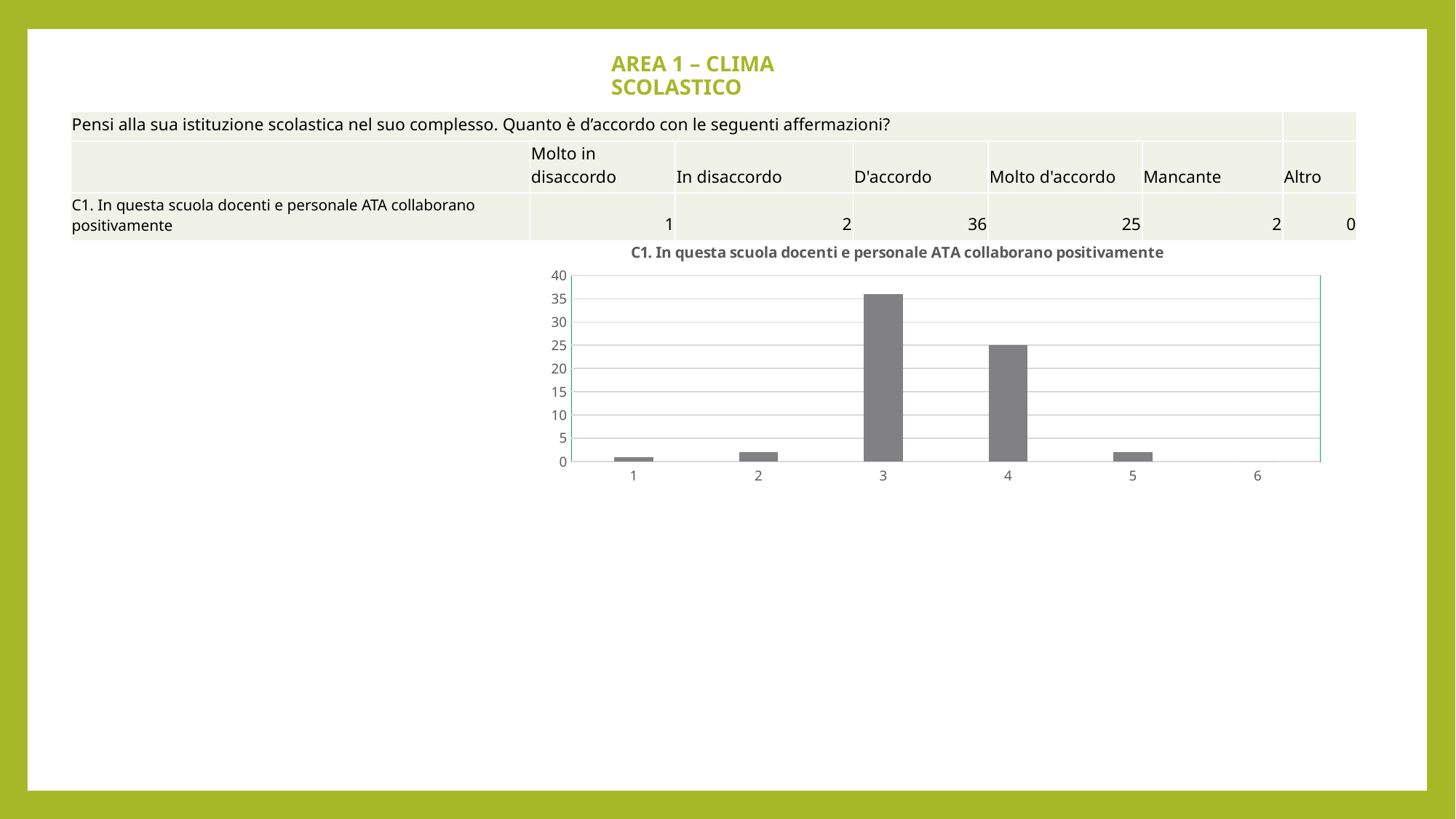
Which is larger, the value for category 2 or the value for category 4? category 4 Is the value for category 5 greater or less than 5? less What is the title of the chart? C1. In questa scuola docenti e personale ATA collaborano positivamente What is the difference between the values for category 3 and category 4? 11 Is the value for category 3 greater or less than 30? greater What is the value of the bar for category 3 (D'accordo)? 36 What is the value of the bar for category 4 (Molto d'accordo)? 25 What is the value of the bar for category 1 (Molto in disaccordo)? 1 What type of chart is shown on the slide? bar chart What is the maximum value shown on the y axis of the chart? 40 Which category has the highest bar in the chart? 3 How many categories are shown on the x axis of the chart? 6